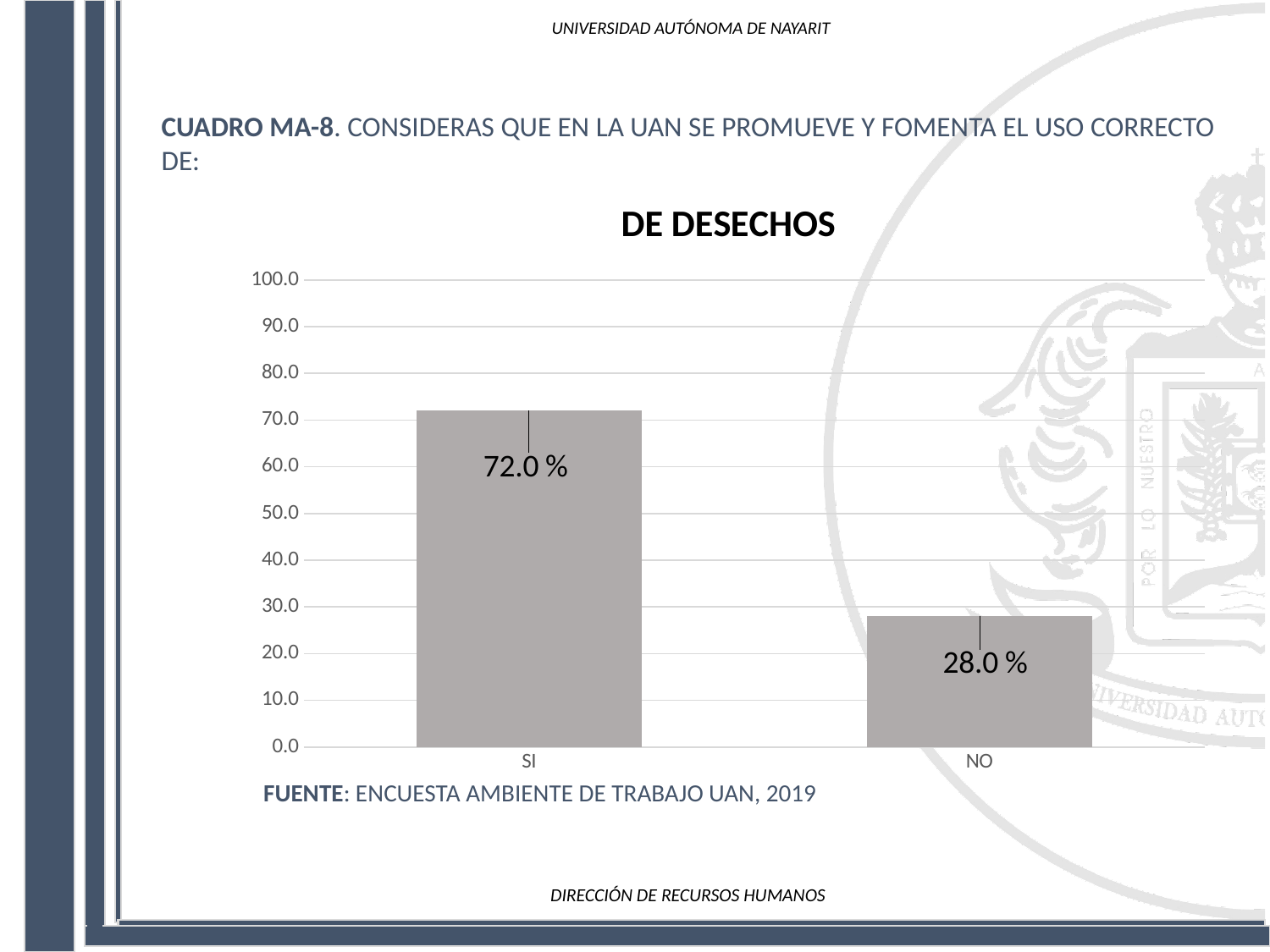
What is the value for NO? 28.0 % What is the title of the chart? DE DESECHOS What kind of chart is shown? bar chart What is the difference between the values for SI and NO? 44.0 % How many categories are shown on the x axis? 2 Is the value for NO greater or less than 30.0? less Which category has the highest value? SI Which category has the lowest value? NO What is the value for SI? 72.0 % Is the value for SI greater or less than 70.0? greater What is the highest value shown on the y axis? 100.0 Which is larger, the value for SI or the value for NO? SI